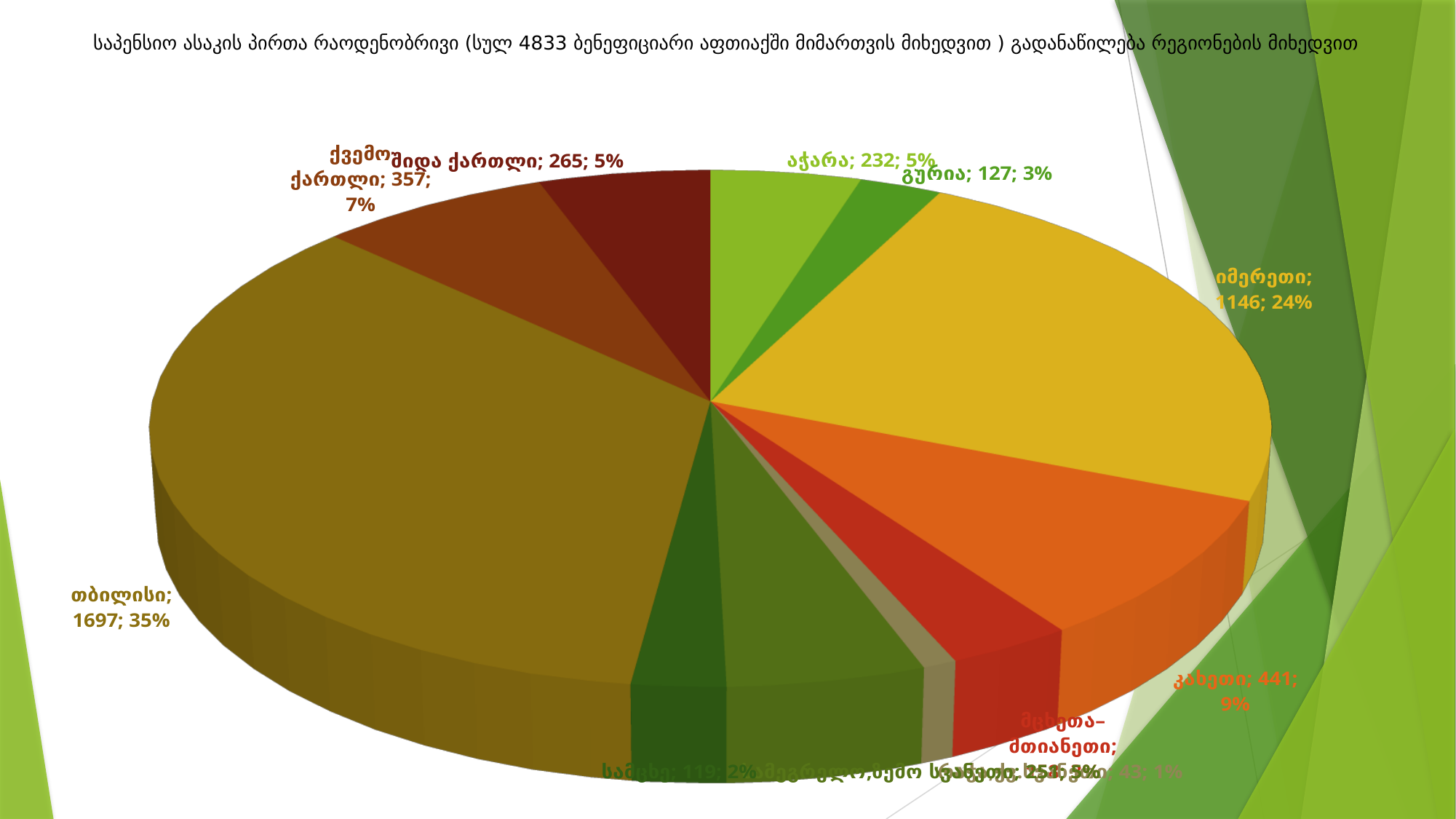
What value is shown for თბილისი? 1697 What is the difference between the values for თბილისი and იმერეთი? 551 What value is shown for კახეთი? 441 What value is shown for იმერეთი? 1146 Which region has the largest slice of the pie? თბილისი What kind of chart is shown on the slide? pie chart What share of the pie does აჭარა represent? 5% Which is larger, the value for ქვემო ქართლი or the value for შიდა ქართლი? ქვემო ქართლი What value is shown for ქვემო ქართლი? 357 According to the chart title, what is the total number of beneficiaries? 4833 What value is shown for გურია? 127 What share of the pie does იმერეთი represent? 24%